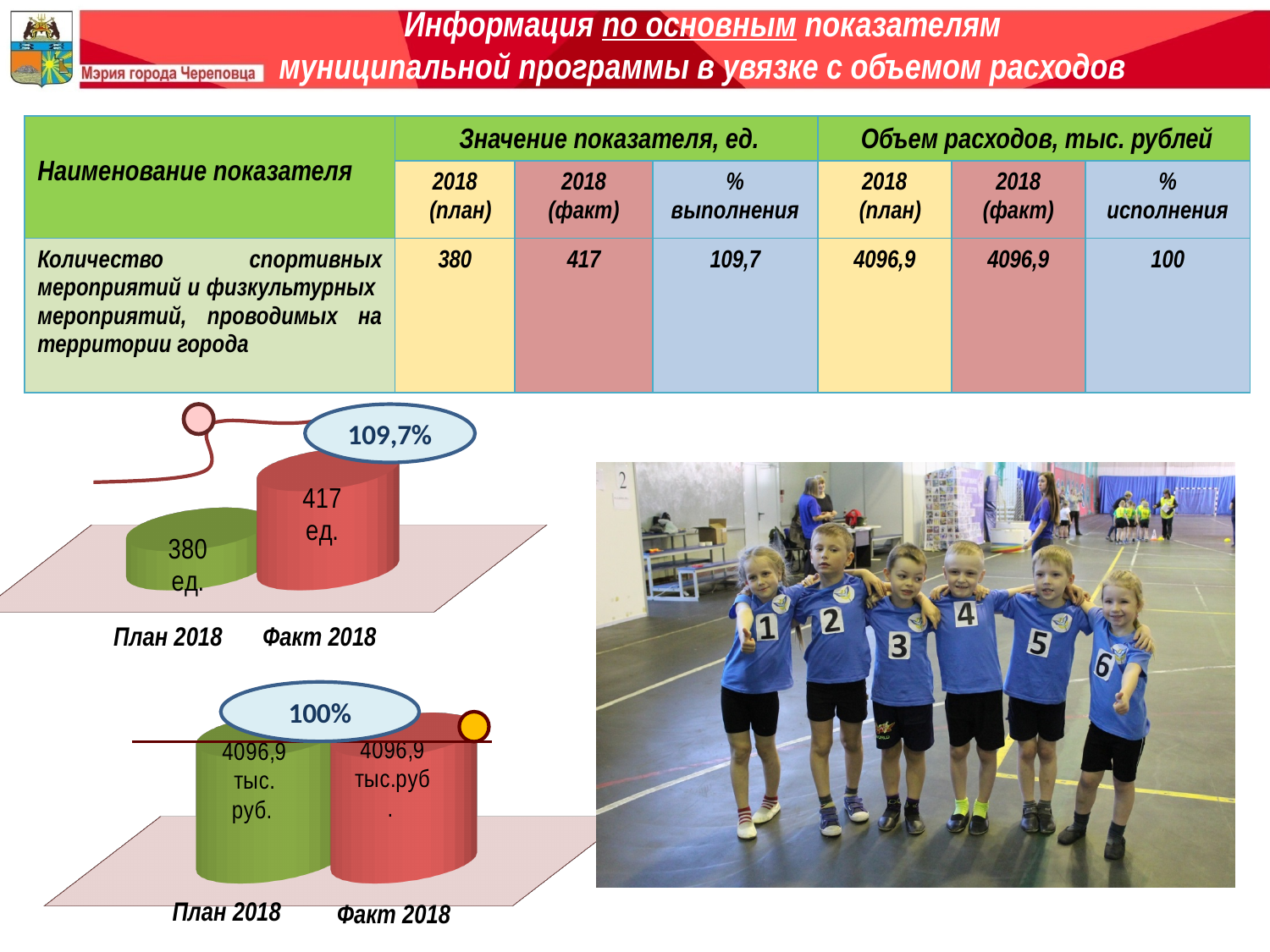
What type of chart is the lower chart? bar chart In the upper chart, what is the value for План 2018? 380 ед. In the lower chart, what is the value for Факт 2018? 4096,9 тыс.руб. What percentage is shown in the callout above the lower chart? 100% How many categories are shown in the upper chart? 2 In the lower chart, what is the difference between the План 2018 and Факт 2018 values? 0 In the upper chart, what is the value for Факт 2018? 417 ед. What percentage is shown in the callout above the upper chart? 109,7% In the lower chart, what is the value for План 2018? 4096,9 тыс. руб. In the upper chart, which category has the lowest value? План 2018 In the upper chart, what is the difference between the Факт 2018 and План 2018 values? 37 ед. In the upper chart, which category has the higher value, План 2018 or Факт 2018? Факт 2018